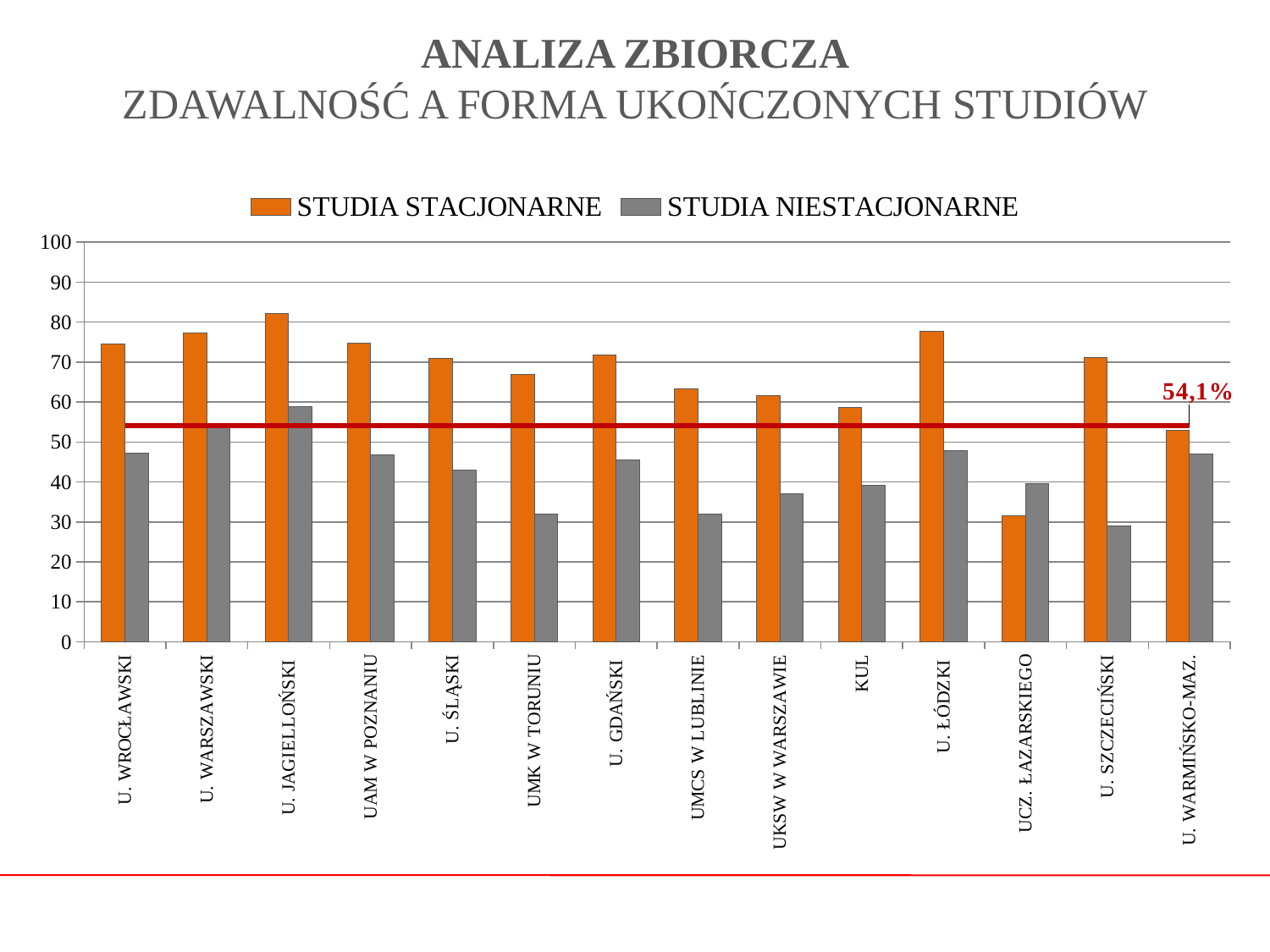
Which university has the highest value for STUDIA NIESTACJONARNE? U. JAGIELLOŃSKI What type of chart is shown on the slide? bar chart Is the STUDIA NIESTACJONARNE value for UMK W TORUNIU greater or less than 40? less How many universities (categories) are shown on the x axis? 14 Which university has the highest value for STUDIA STACJONARNE? U. JAGIELLOŃSKI Which university has the lowest value for STUDIA STACJONARNE? UCZ. ŁAZARSKIEGO How many series does the legend list? 2 What value is labelled on the horizontal red reference line? 54,1% Which series is shown in orange in the legend? STUDIA STACJONARNE Is the STUDIA STACJONARNE value for U. WROCŁAWSKI greater or less than 70? greater Is the STUDIA STACJONARNE value for UCZ. ŁAZARSKIEGO greater or less than 40? less Which is larger: the STUDIA STACJONARNE value for U. ŁÓDZKI or for KUL? U. ŁÓDZKI